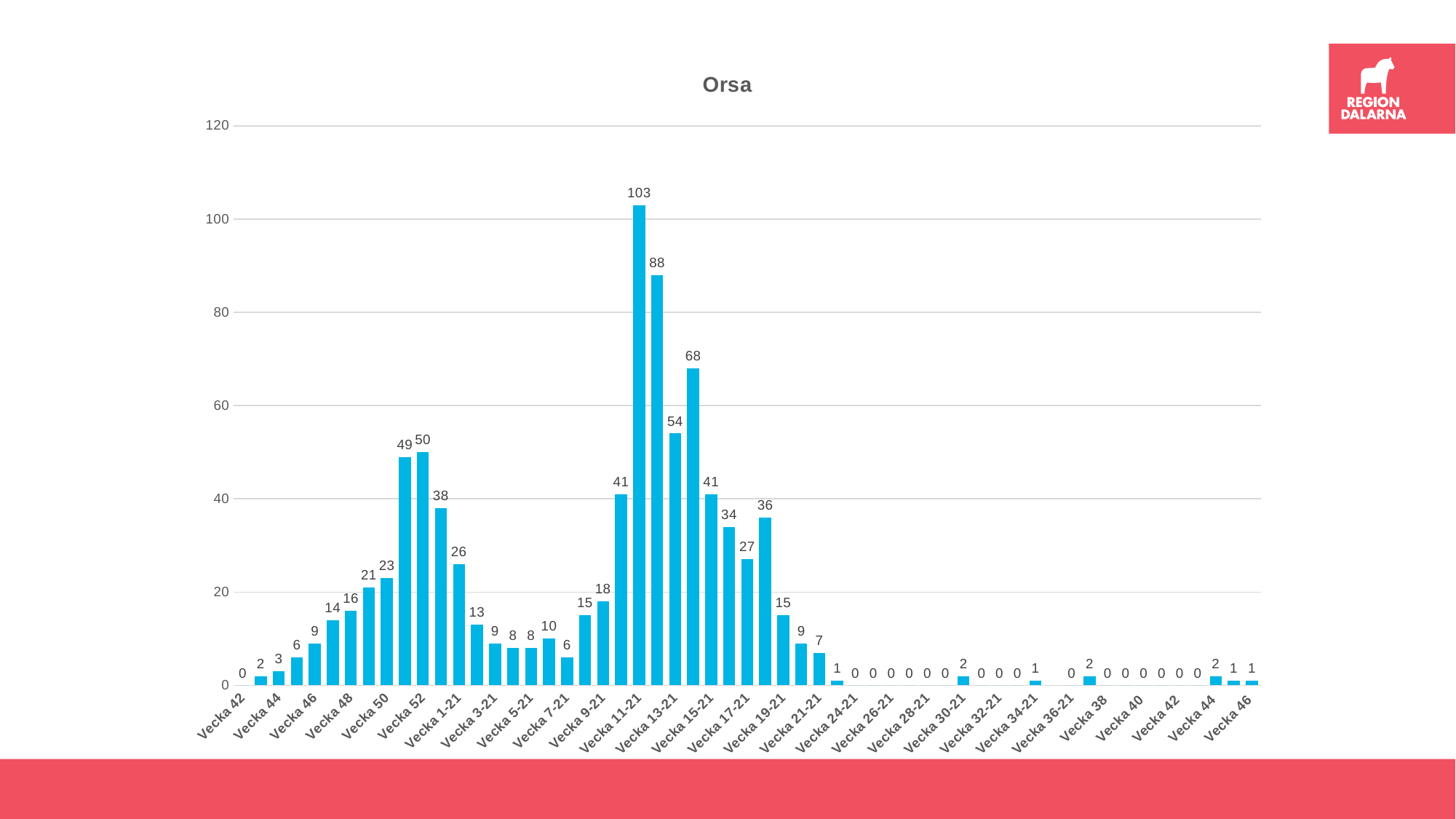
Is the value for Vecka 11-21 greater or less than 100? greater What is the difference between the values for Vecka 11-21 and Vecka 13-21? 49 What is the title of the chart? Orsa Which is larger, the value for Vecka 50 or the value for Vecka 1-21? Vecka 1-21 Do the values rise or fall from Vecka 13-21 to Vecka 21-21? fall What kind of chart is shown on the slide? bar chart What is the value for Vecka 11-21? 103 What is the value for Vecka 52? 50 What is the value for Vecka 13-21? 54 What is the value for Vecka 17-21? 27 What is the value for Vecka 9-21? 18 Which week has the highest value in the chart? Vecka 11-21